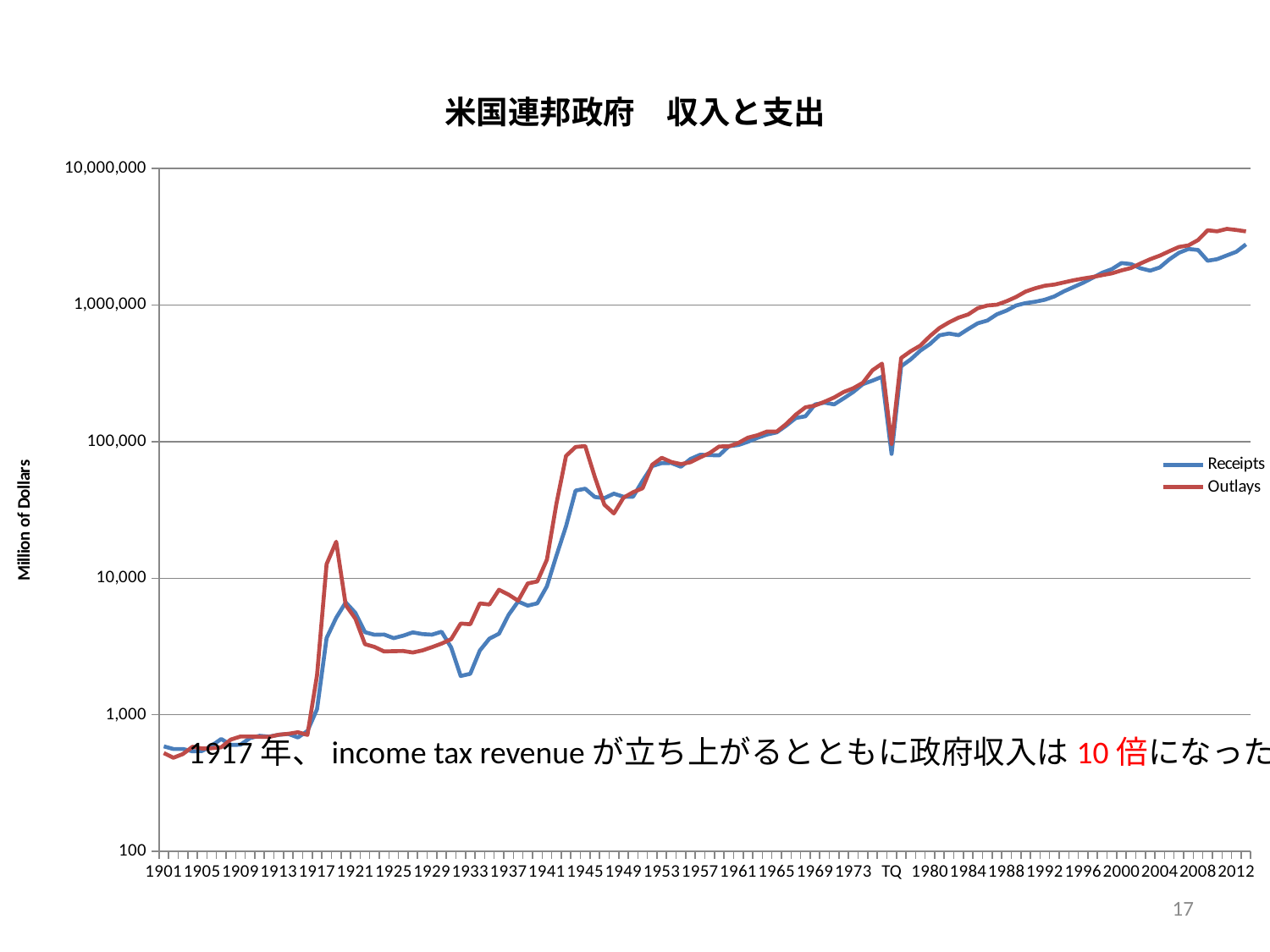
Is the value for Receipts in 1901 greater or less than 1,000? less What kind of chart is shown on the slide? line chart Is the value for Receipts in 1933 greater or less than 10,000? less In 2012, which series has the higher value, Receipts or Outlays? Outlays What is the title of the chart? 米国連邦政府 収入と支出 In 1921, which series has the higher value, Receipts or Outlays? Receipts Is the value for Receipts in 1945 greater or less than 100,000? less Overall, do Receipts rise or fall from 1901 to 2012? rise What is the label on the vertical axis? Million of Dollars How many series does the legend list? 2